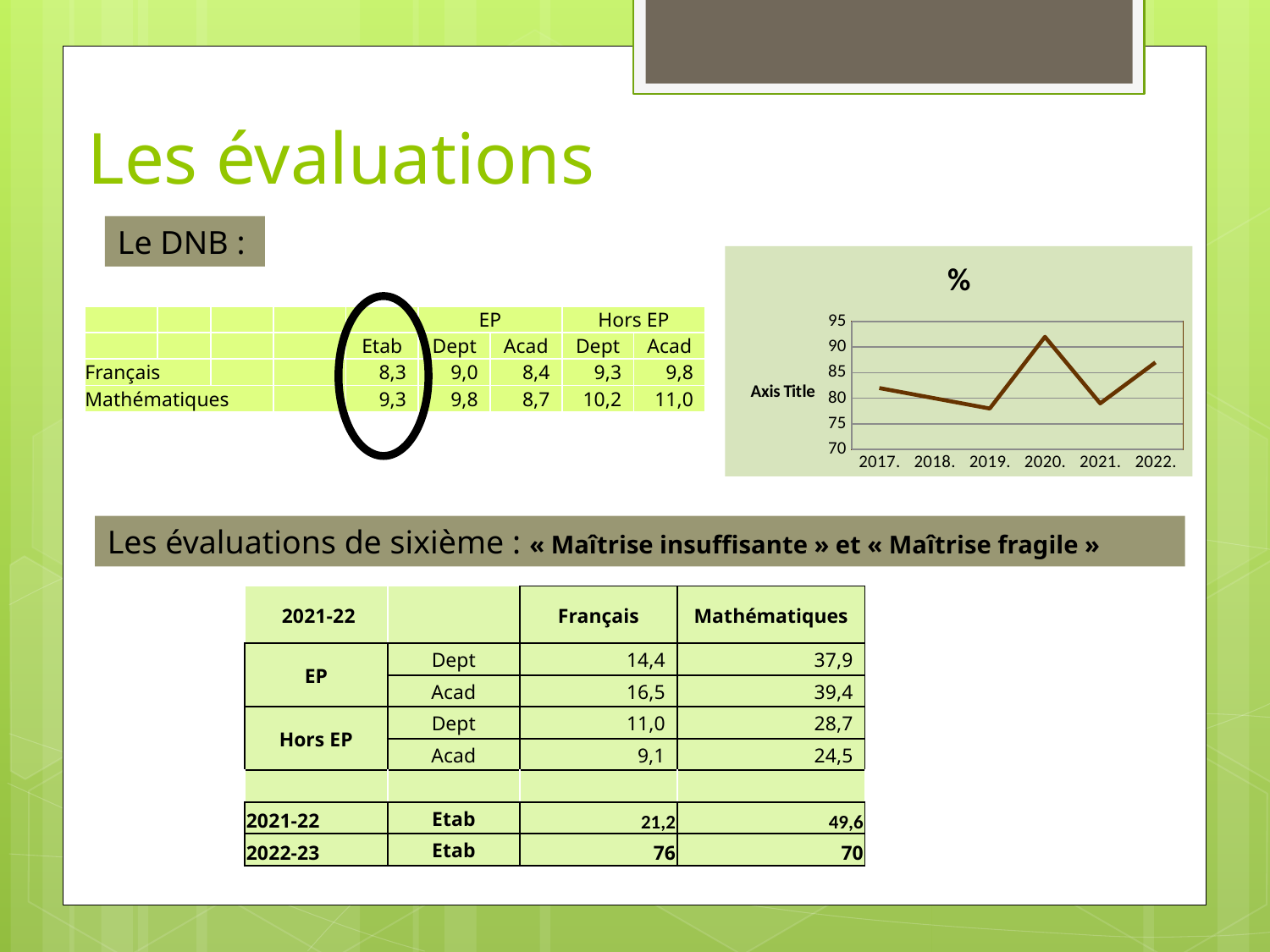
What kind of chart is shown on the slide? line chart How many years are plotted along the x axis of the chart? 6 Is the value for 2020. greater or less than 90? greater What label is shown on the vertical axis of the chart? Axis Title What is the title of the chart? % Is the value for 2018. greater or less than 85? less Is the value for 2022. greater or less than 85? greater Do the values rise or fall from 2017. to 2019.? fall Which is larger, the value for 2022. or the value for 2017.? 2022. Which is larger, the value for 2020. or the value for 2021.? 2020. Which year has the highest value in the chart? 2020.